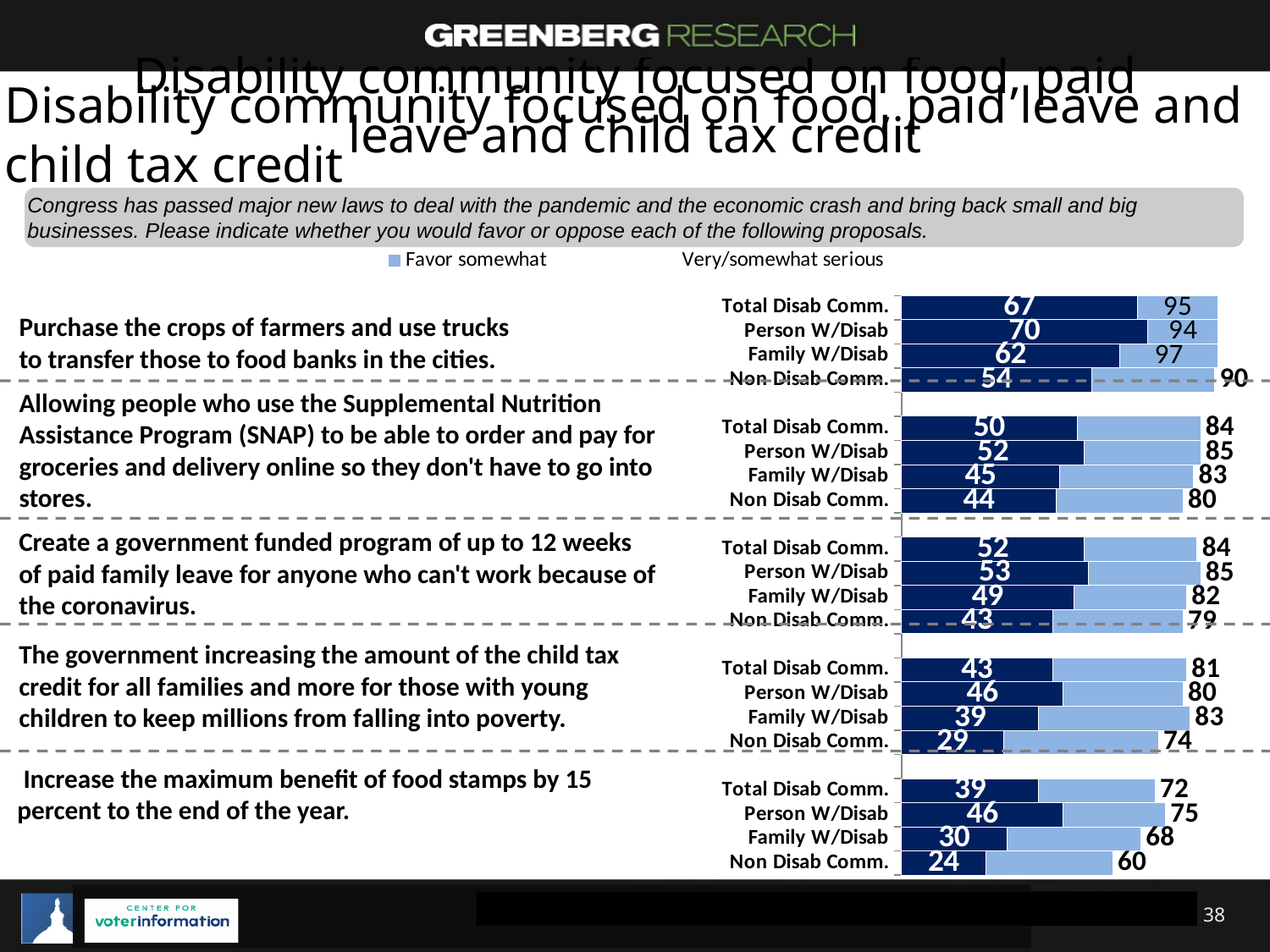
For the child tax credit proposal, what is the difference between the total values for Family W/Disab and Non Disab Comm.? 9 For the SNAP online ordering proposal, what is the dark-blue value for Non Disab Comm.? 44 For the child tax credit proposal, what is the dark-blue value for Non Disab Comm.? 29 For the proposal to purchase the crops of farmers and transfer them to food banks, what is the dark-blue value for Person W/Disab? 70 What type of chart is shown on the slide? bar chart For the paid family leave proposal, which is larger: the dark-blue value for Person W/Disab or for Non Disab Comm.? Person W/Disab For the proposal to purchase the crops of farmers, which group has the highest total value shown at the end of the bar? Family W/Disab How many groups are shown for each proposal in the chart? 4 For the proposal to increase the maximum food stamp benefit by 15 percent, what is the total value shown for Non Disab Comm.? 60 For the proposal to increase the maximum food stamp benefit by 15 percent, which group has the lowest dark-blue value? Non Disab Comm. For the 12 weeks of paid family leave proposal, what is the total value shown for Total Disab Comm.? 84 For the proposal to purchase the crops of farmers and transfer them to food banks, what is the total value shown at the end of the bar for Family W/Disab? 97